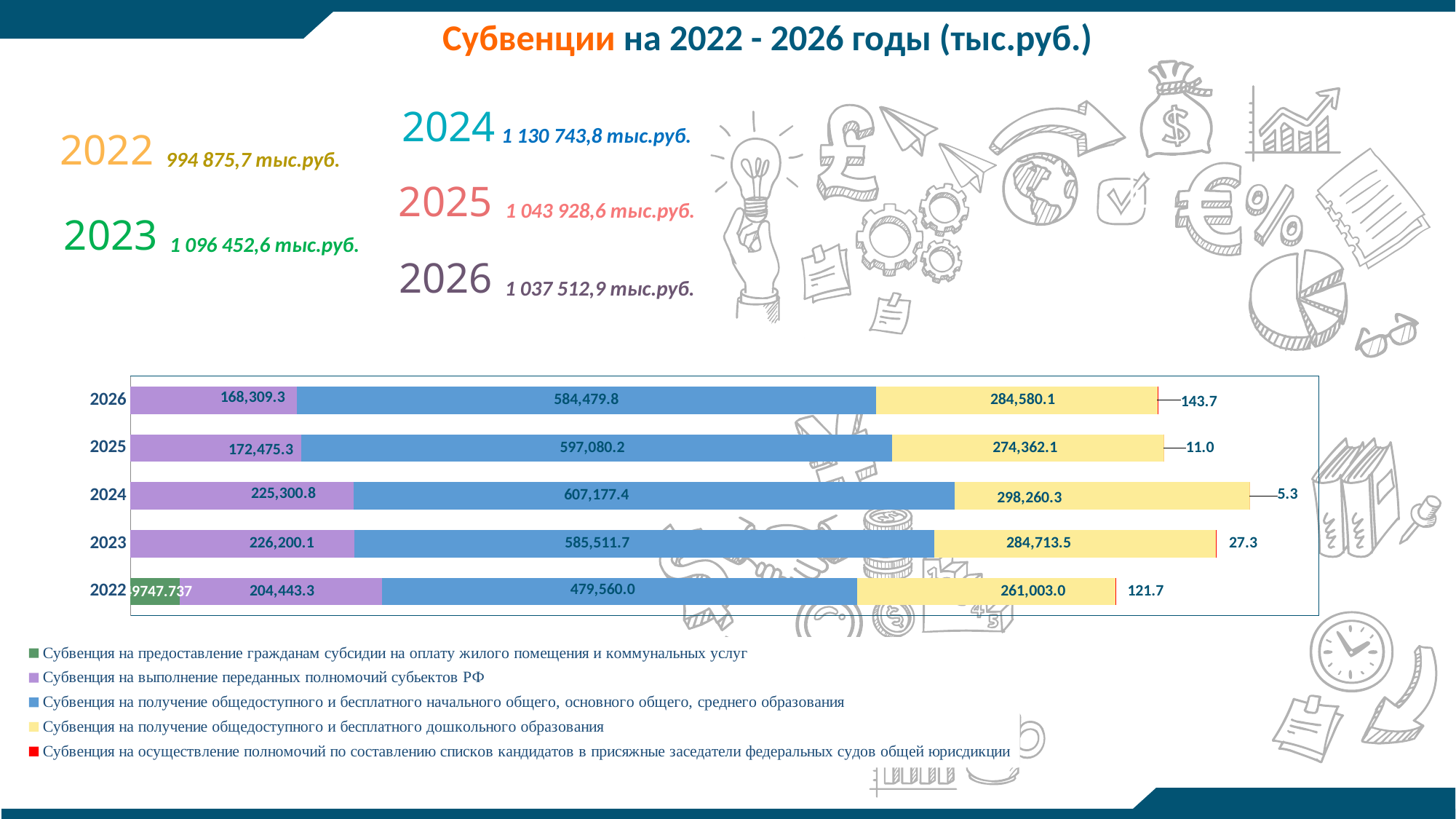
What is the value of the blue series (Субвенция на получение общедоступного и бесплатного начального общего, основного общего, среднего образования) for 2024? 607,177.4 What is the value of the yellow series (Субвенция на получение общедоступного и бесплатного дошкольного образования) for 2022? 261,003.0 What kind of chart is shown on the slide? Stacked horizontal bar chart Which colour represents Субвенция на получение общедоступного и бесплатного дошкольного образования in the legend? Yellow What is the difference between the blue series values for 2024 and 2025? 10,097.2 In which year is the blue series (начального общего, основного общего, среднего образования) highest? 2024 What is the value of the purple series (Субвенция на выполнение переданных полномочий субъектов РФ) for 2026? 168,309.3 How many years (categories) are shown in the chart? 5 How many series does the legend list? 5 Which is larger: the purple series value for 2023 or for 2026? 2023 In which year is the red series (списков кандидатов в присяжные заседатели) lowest? 2024